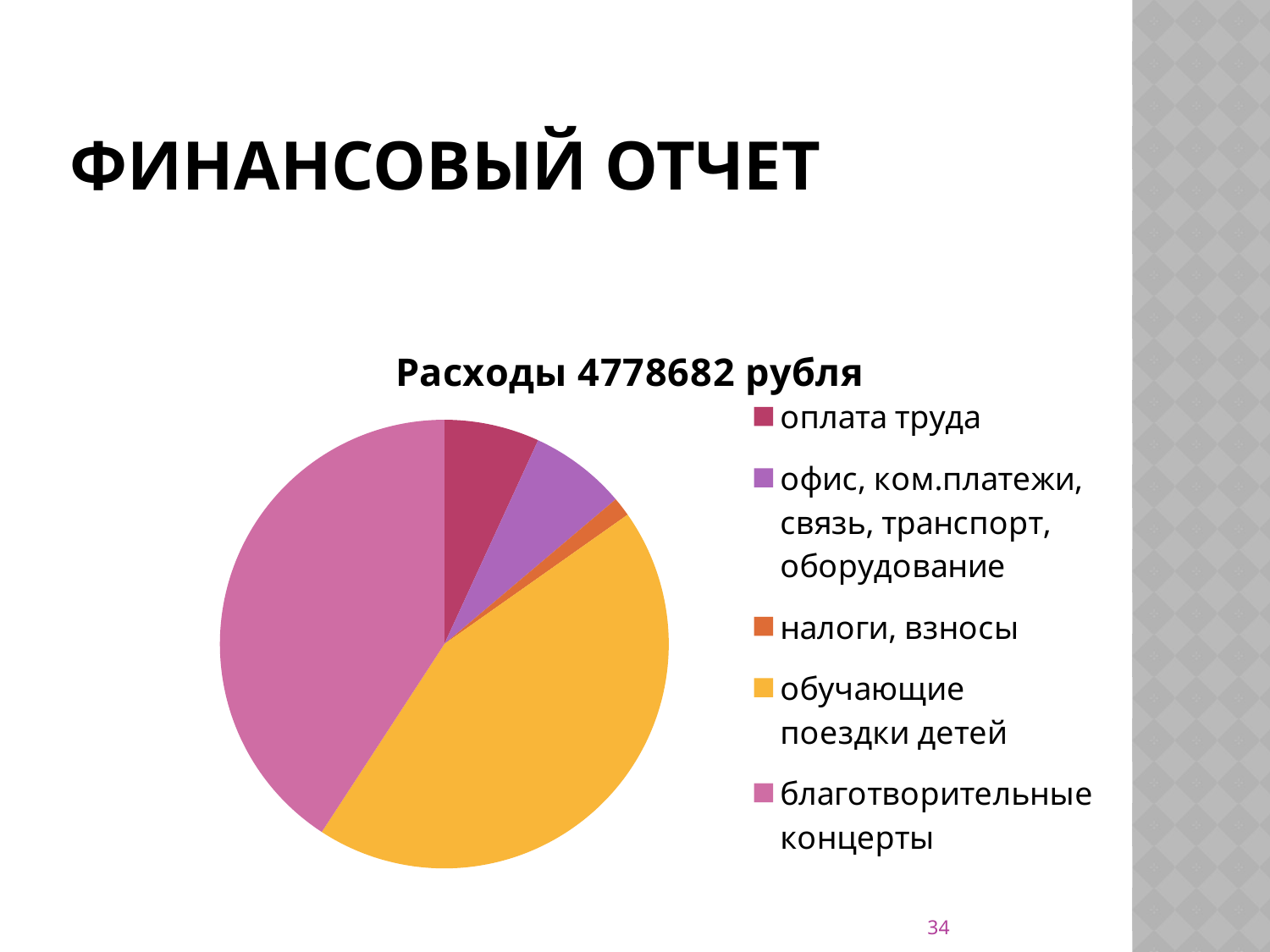
How many slices does the pie chart have? 5 Which category has the smallest slice of the pie? налоги, взносы Which slice is larger: благотворительные концерты or офис, ком.платежи, связь, транспорт, оборудование? благотворительные концерты What is the title of the chart? Расходы 4778682 рубля What kind of chart is shown on the slide? pie chart Which category is listed first in the legend? оплата труда Which slice is larger: обучающие поездки детей or благотворительные концерты? обучающие поездки детей Which category has the largest slice of the pie? обучающие поездки детей What colour is the slice for обучающие поездки детей? yellow Which slice is larger: оплата труда or налоги, взносы? оплата труда How many entries does the chart legend list? 5